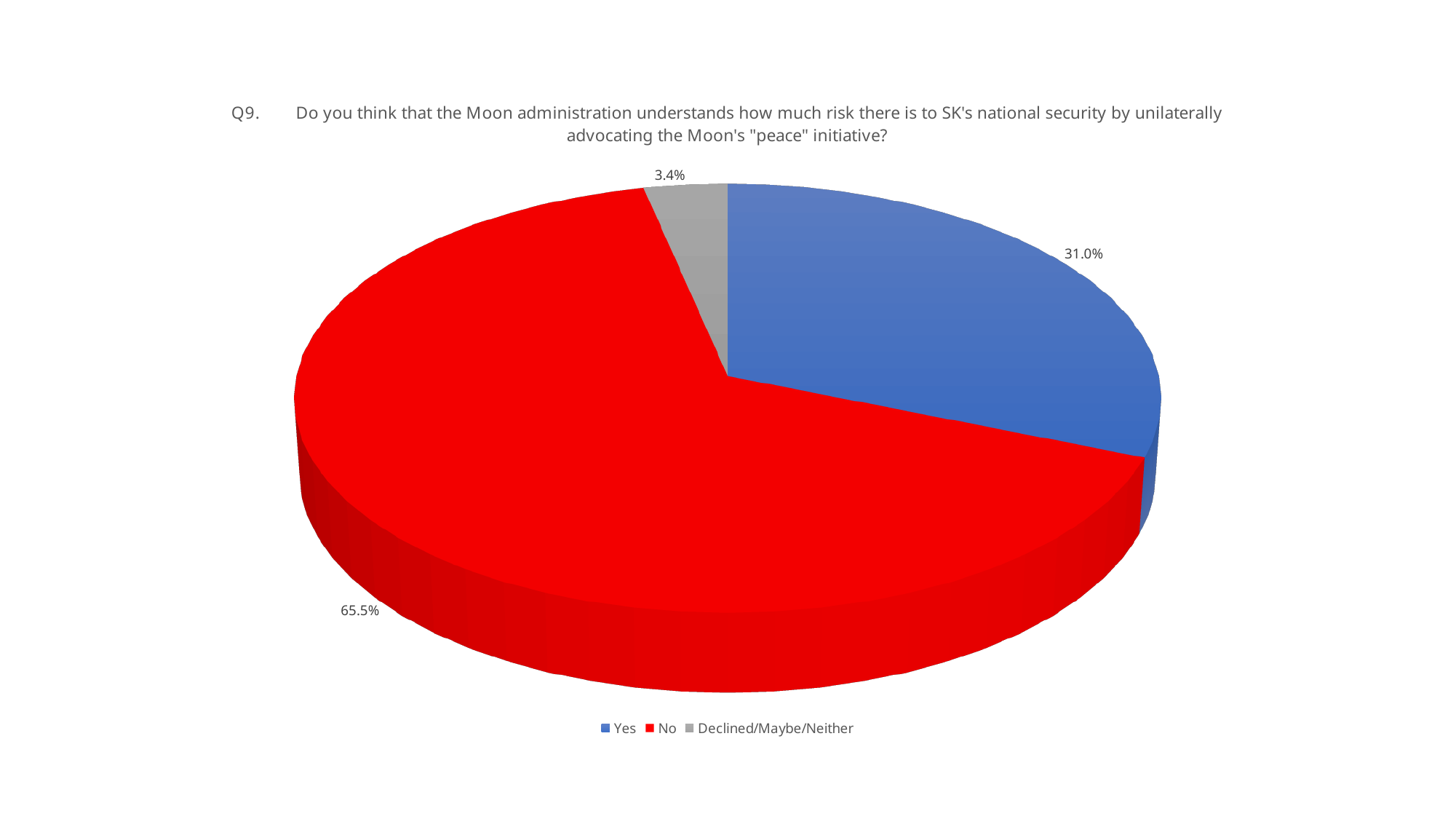
Which response has the largest share of the pie? No Which response has the smallest share of the pie? Declined/Maybe/Neither What kind of chart is shown on the slide? Pie chart How many entries does the legend list? 3 What percentage of respondents answered "No"? 65.5% What percentage of respondents are in the "Declined/Maybe/Neither" category? 3.4% What percentage of respondents answered "Yes"? 31.0% Which is larger, the "Yes" slice or the "Declined/Maybe/Neither" slice? Yes What is the question number shown in the chart title? Q9 What colour is the "No" slice? Red How many slices does the pie chart have? 3 What is the difference in percentage points between the "No" and "Yes" slices? 34.5